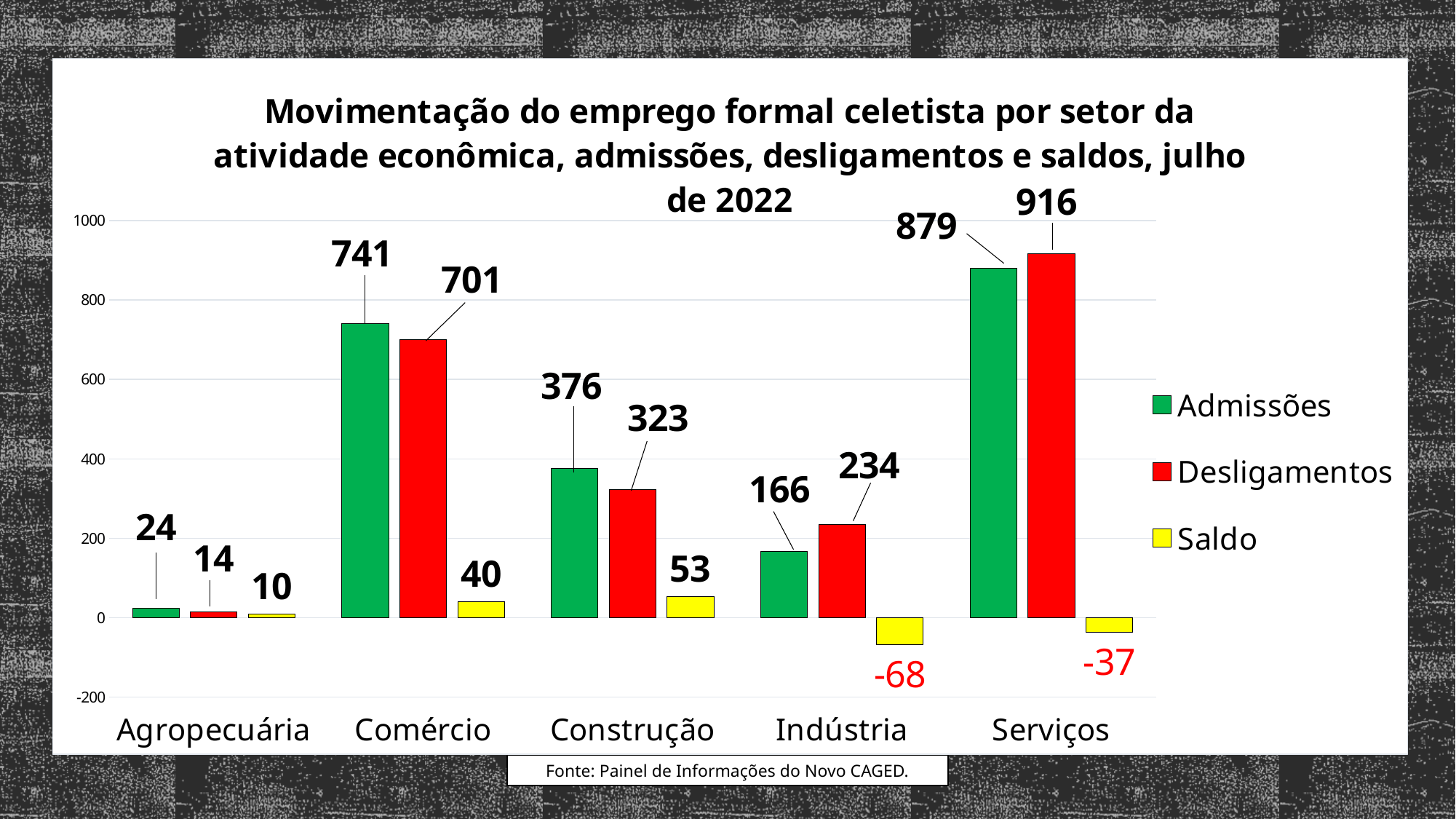
Which sector has the highest Admissões value? Serviços How many series does the legend list? 3 What is the value of Desligamentos for Indústria? 234 Which sector has the lowest Desligamentos value? Agropecuária What is the value of Admissões for Comércio? 741 What colour represents the Saldo series? yellow Which is larger for Indústria, Admissões or Desligamentos? Desligamentos What is the Saldo value for Serviços? -37 What kind of chart is shown? bar chart Is the Desligamentos value for Serviços greater or less than 800? greater What is the difference between Admissões and Desligamentos for Construção? 53 How many sectors are shown on the x axis? 5